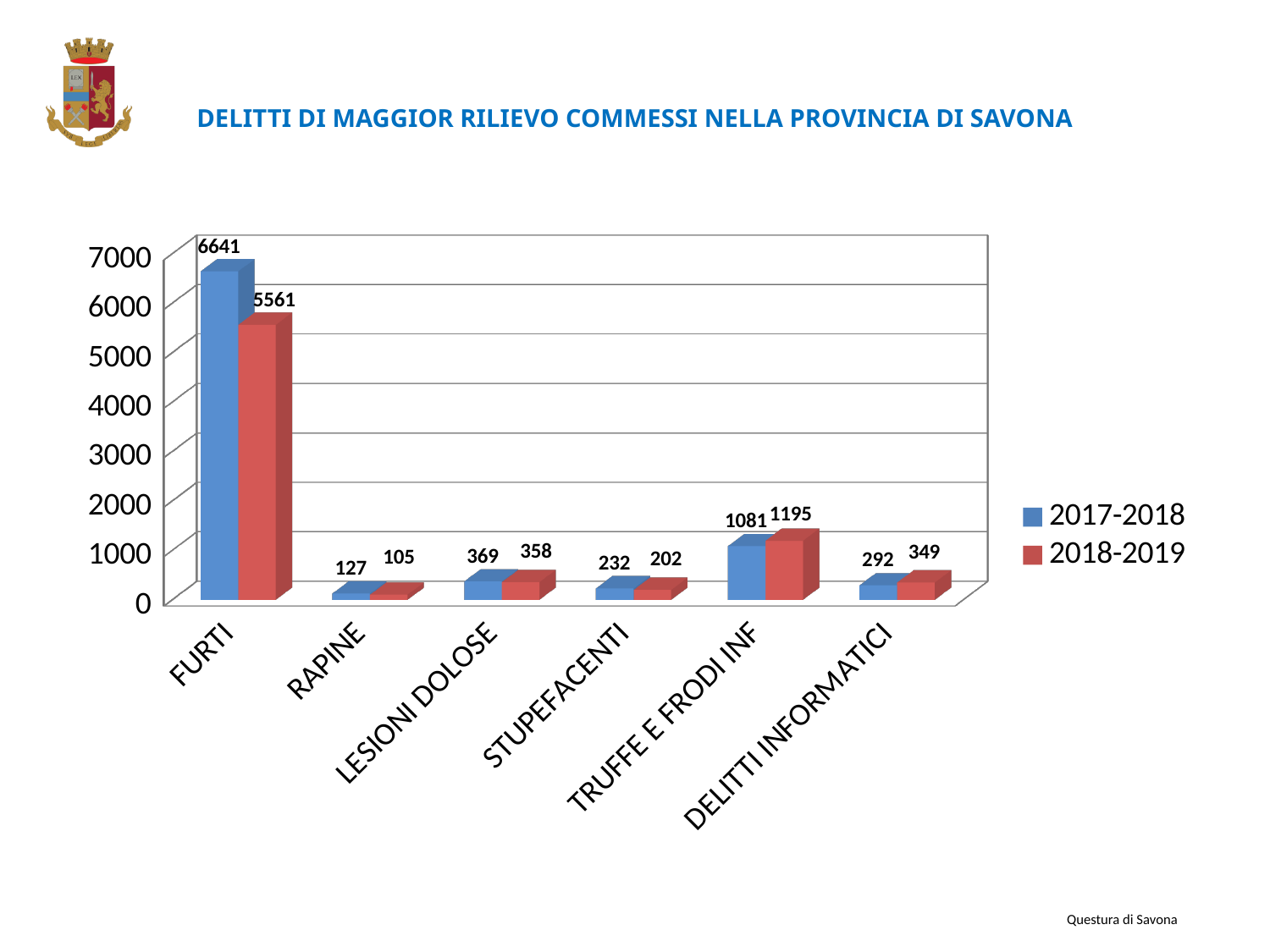
Which is larger for STUPEFACENTI: the 2017-2018 value or the 2018-2019 value? 2017-2018 What is the difference between the 2018-2019 and 2017-2018 values for DELITTI INFORMATICI? 57 What is the value for RAPINE in the 2018-2019 series? 105 How many series does the legend list? 2 What is the value for TRUFFE E FRODI INF in the 2018-2019 series? 1195 Is the 2018-2019 value for FURTI greater or less than 6000? less What is the difference between the 2017-2018 and 2018-2019 values for FURTI? 1080 Which category has the lowest value in the 2018-2019 series? RAPINE What is the value for FURTI in the 2017-2018 series? 6641 What kind of chart is shown on the slide? bar chart Which category has the highest value in the 2017-2018 series? FURTI How many categories are shown on the x axis? 6